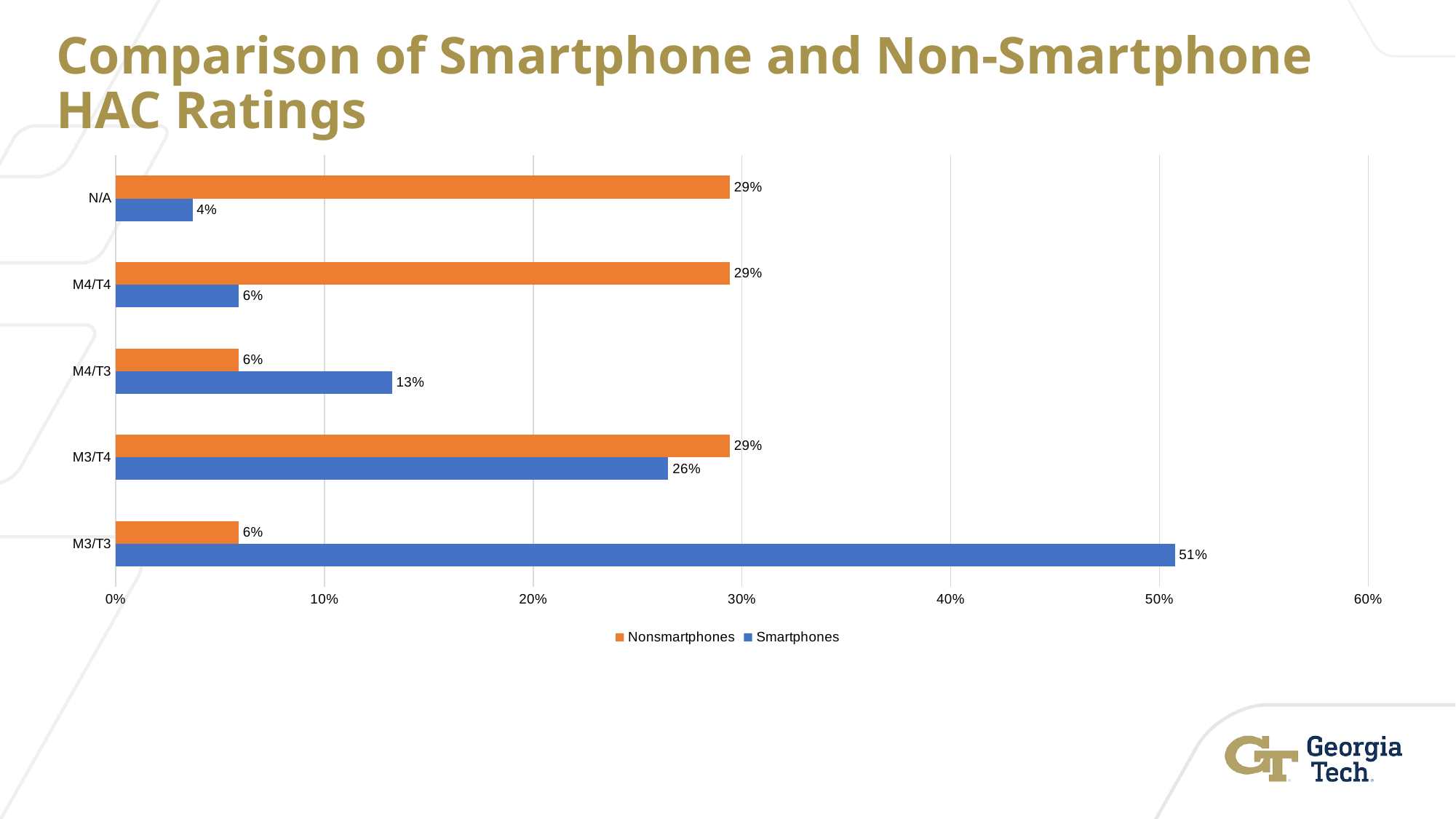
Which category has the highest Smartphones value? M3/T3 For M4/T3, which series has the larger value, Smartphones or Nonsmartphones? Smartphones What is the difference between the Nonsmartphones and Smartphones values for M4/T4? 23% What is the Nonsmartphones value for M4/T3? 6% What is the difference between the Smartphones and Nonsmartphones values for M3/T3? 45% What is the Smartphones value for N/A? 4% How many categories are shown on the chart? 5 Is the Smartphones value for M3/T3 greater or less than 50%? greater What is the Smartphones value for M3/T3? 51% Which category has the lowest Smartphones value? N/A What kind of chart is shown on the slide? Bar chart How many series does the legend list? 2